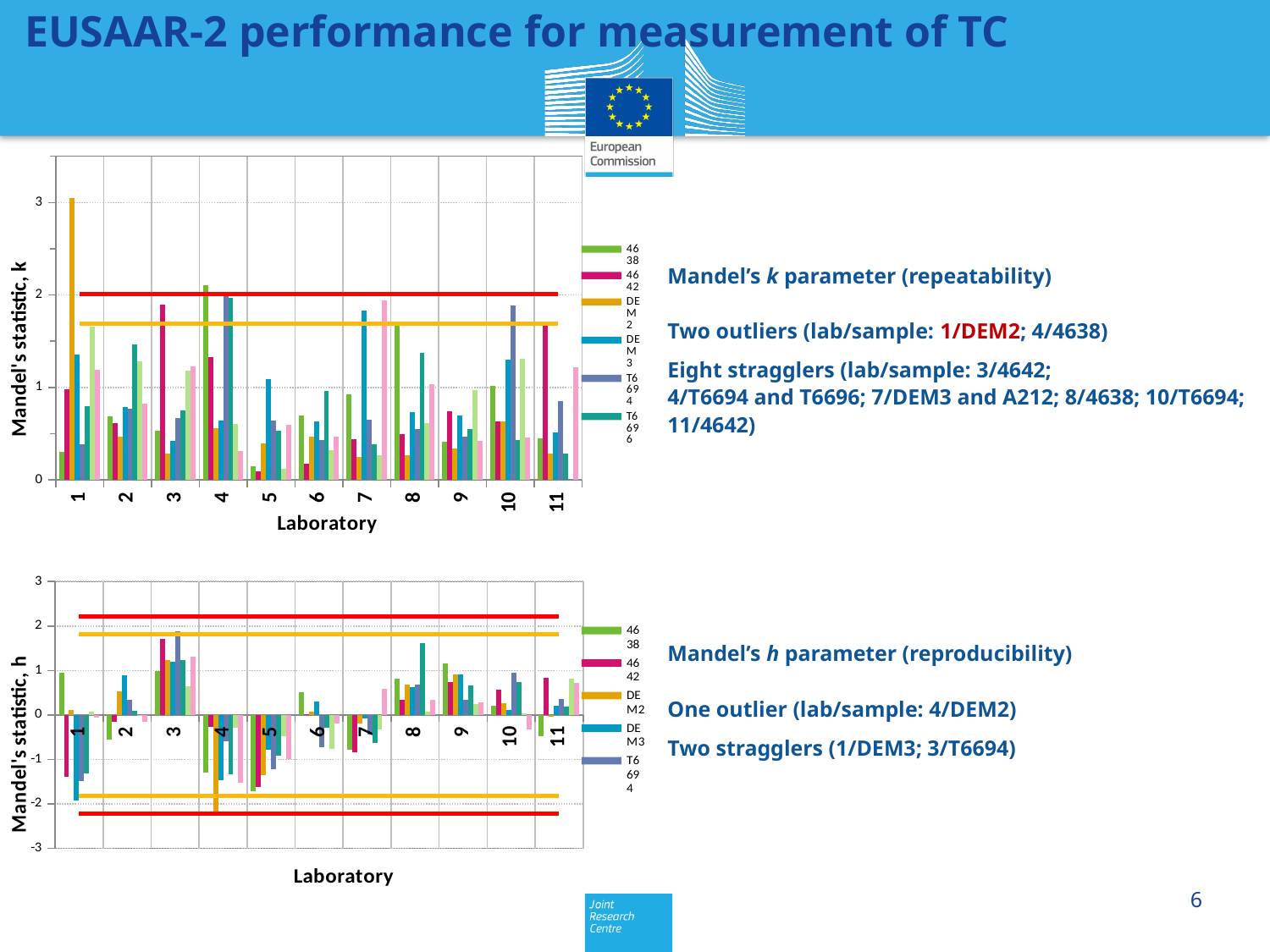
In the top chart (Mandel's statistic, k), which is larger: the DEM2 value for laboratory 1 or the DEM2 value for laboratory 2? laboratory 1 In the top chart (Mandel's statistic, k), which laboratory has the highest bar? 1 What is the x-axis title of the bottom chart (Mandel's statistic, h)? Laboratory What kind of chart is the top chart (Mandel's statistic, k)? bar chart How many laboratories are shown on the x axis of the top chart (Mandel's statistic, k)? 11 How many series does the legend of the top chart (Mandel's statistic, k) list? 6 In the top chart (Mandel's statistic, k), is the DEM2 value for laboratory 1 greater or less than 2? greater How many series does the legend of the bottom chart (Mandel's statistic, h) list? 5 In the bottom chart (Mandel's statistic, h), is the DEM2 value for laboratory 4 greater or less than -2? less In the bottom chart (Mandel's statistic, h), which laboratory has the lowest bar? 4 In the bottom chart (Mandel's statistic, h), is the 4642 value for laboratory 3 greater or less than 1? greater